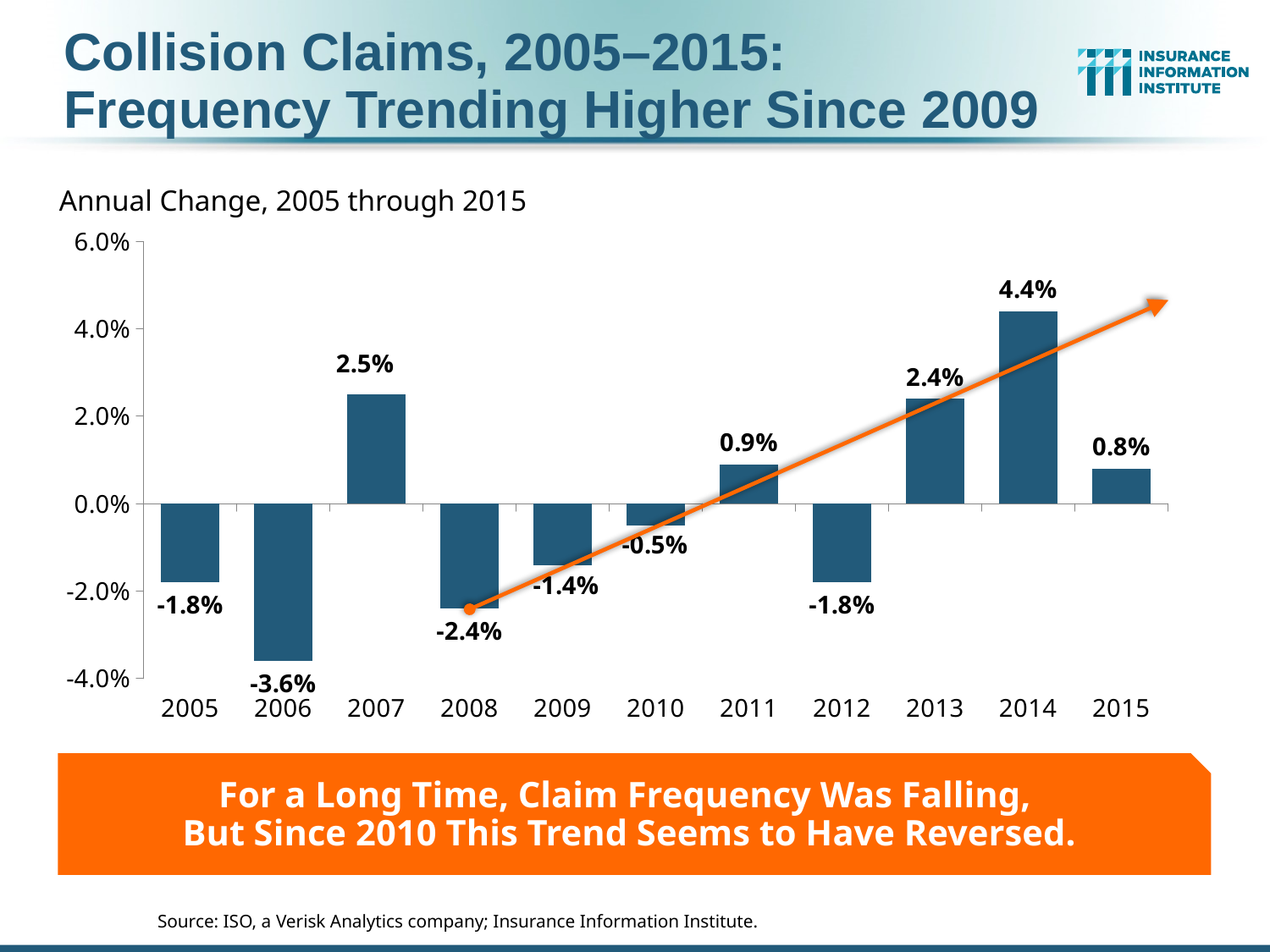
What is the annual change shown for 2010? -0.5% How many years are shown on the x axis? 11 What is the annual change shown for 2006? -3.6% Which year has the larger annual change, 2007 or 2011? 2007 What is the difference between the annual change in 2014 and in 2013? 2.0% Do the values generally rise or fall from 2009 to 2014? Rise Which year has the lowest annual change? 2006 Which year has the highest annual change? 2014 What is the annual change in collision claim frequency for 2014? 4.4% Is the value for 2008 greater or less than -2.0%? less What is the subtitle printed above the chart? Annual Change, 2005 through 2015 What kind of chart is shown on the slide? Bar chart